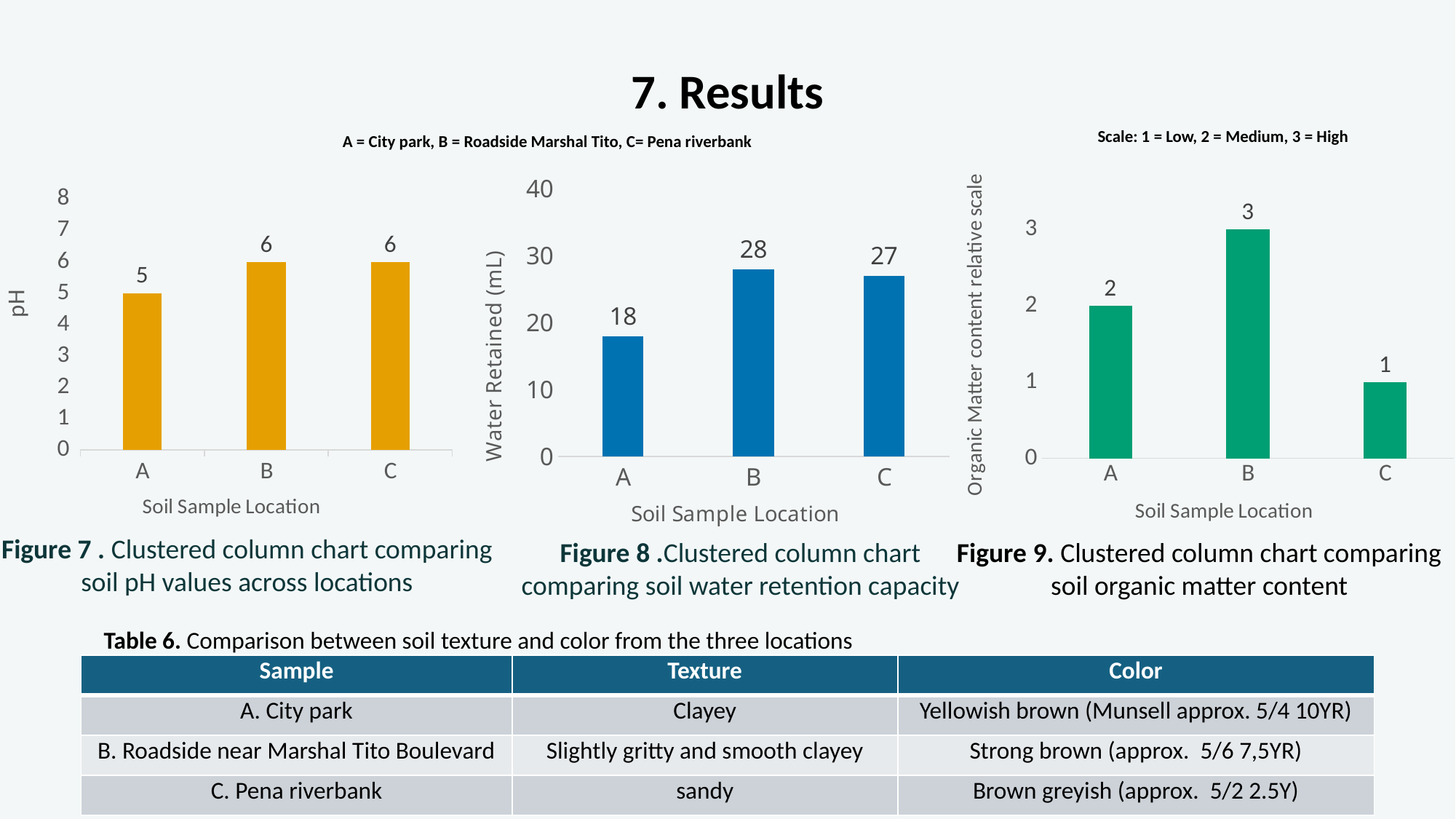
How many soil sample locations are shown in the Figure 7 pH chart? 3 In the Figure 9 organic matter chart, is the value for location A larger or smaller than the value for location C? larger What kind of chart is Figure 8? bar chart In the Figure 8 water retention chart, is the value for location C greater or less than 20? greater In the Figure 8 water retention chart, which location has the lowest water retained? A In the Figure 8 water retention chart, what is the water retained for location B? 28 In the Figure 7 pH chart, what is the pH value for location A? 5 What is the y-axis label of the Figure 8 chart? Water Retained (mL) In the Figure 8 water retention chart, what is the difference in water retained between location B and location A? 10 In the Figure 7 pH chart, what is the difference in pH between location B and location A? 1 In the Figure 9 organic matter chart, what is the value for location C? 1 In the Figure 9 organic matter chart, which location has the highest value? B